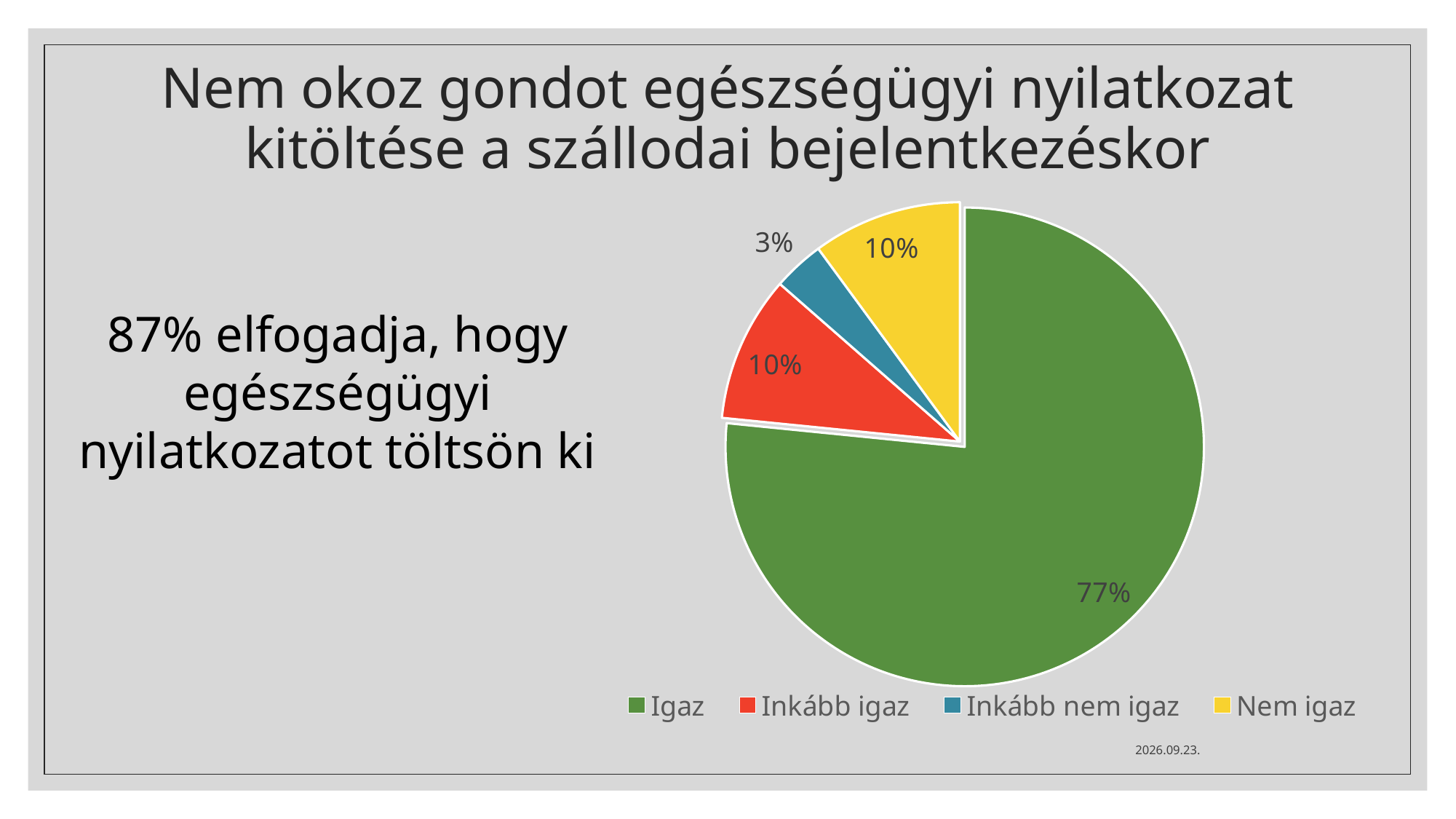
What colour is the "Nem igaz" slice in the pie chart? yellow What type of chart is shown on the slide? pie chart Which category has the largest slice of the pie? Igaz How many entries does the legend list? 4 What share of the pie does the "Igaz" slice represent? 77% What is the difference in percentage points between the "Igaz" slice and the "Nem igaz" slice? 67 Which category has the smallest slice of the pie? Inkább nem igaz How many slices does the pie chart have? 4 What share of the pie does the "Nem igaz" slice represent? 10% What share of the pie does the "Inkább igaz" slice represent? 10% Which is larger, the "Inkább igaz" slice or the "Inkább nem igaz" slice? Inkább igaz